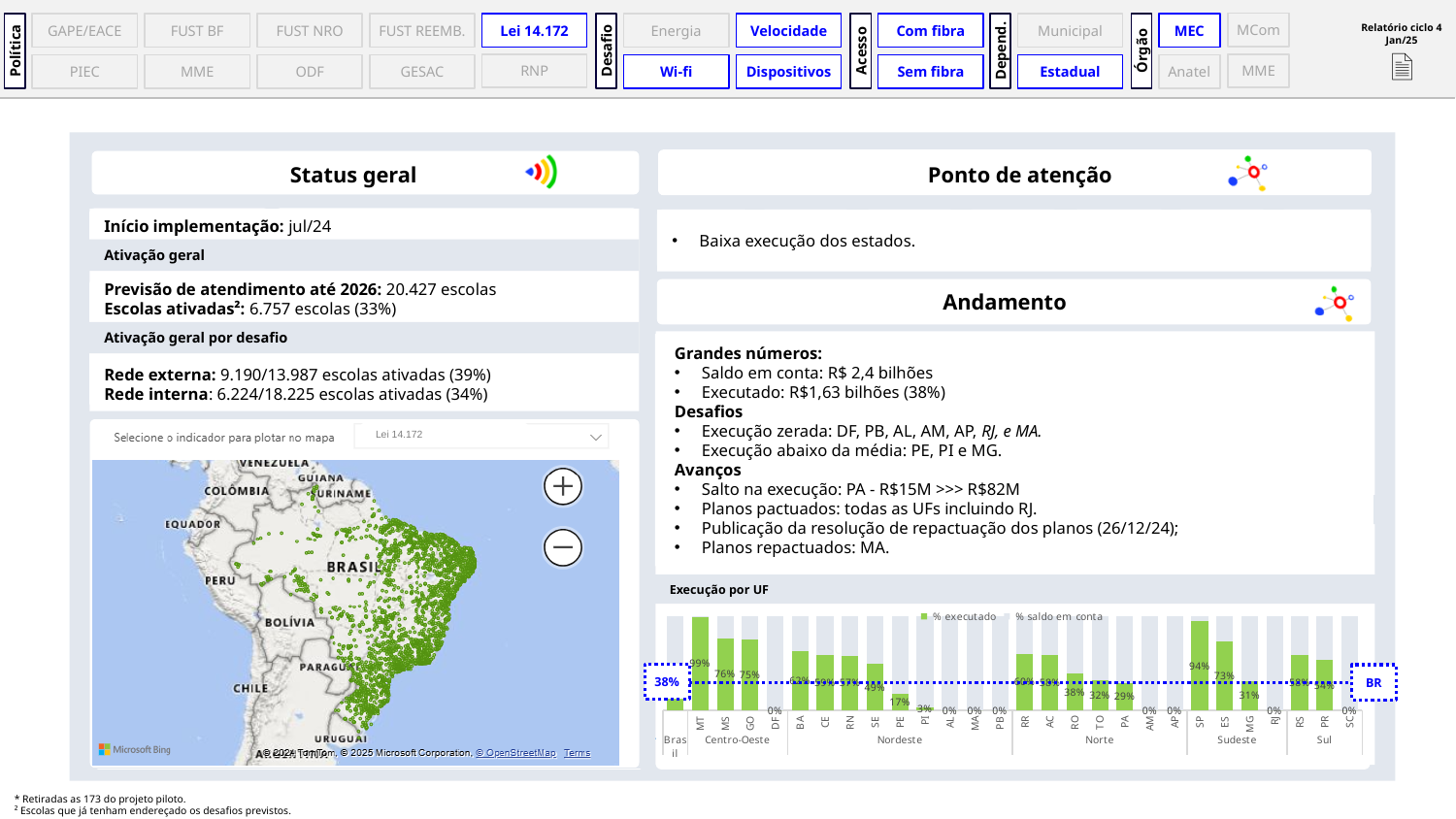
In the 'Execução por UF' chart, which UF has the highest % executado? MT In the 'Execução por UF' chart, what is the % executado value for DF? 0% In the 'Execução por UF' chart, what is the difference in % executado between SP and ES? 21 percentage points In the 'Execução por UF' chart, what are the two legend entries? % executado and % saldo em conta In the 'Execução por UF' chart, what is the % executado value for SP? 94% What kind of chart is 'Execução por UF'? bar chart In the 'Execução por UF' chart, what is the % executado value for PE? 17% In the 'Execução por UF' chart, which has a higher % executado, MT or SP? MT In the 'Execução por UF' chart, what is the % executado value for Brasil? 38% In the 'Execução por UF' chart, what is the % executado value for MT? 99% How many series does the legend of the 'Execução por UF' chart list? 2 In the 'Execução por UF' chart, what is the % executado value for PI? 3%